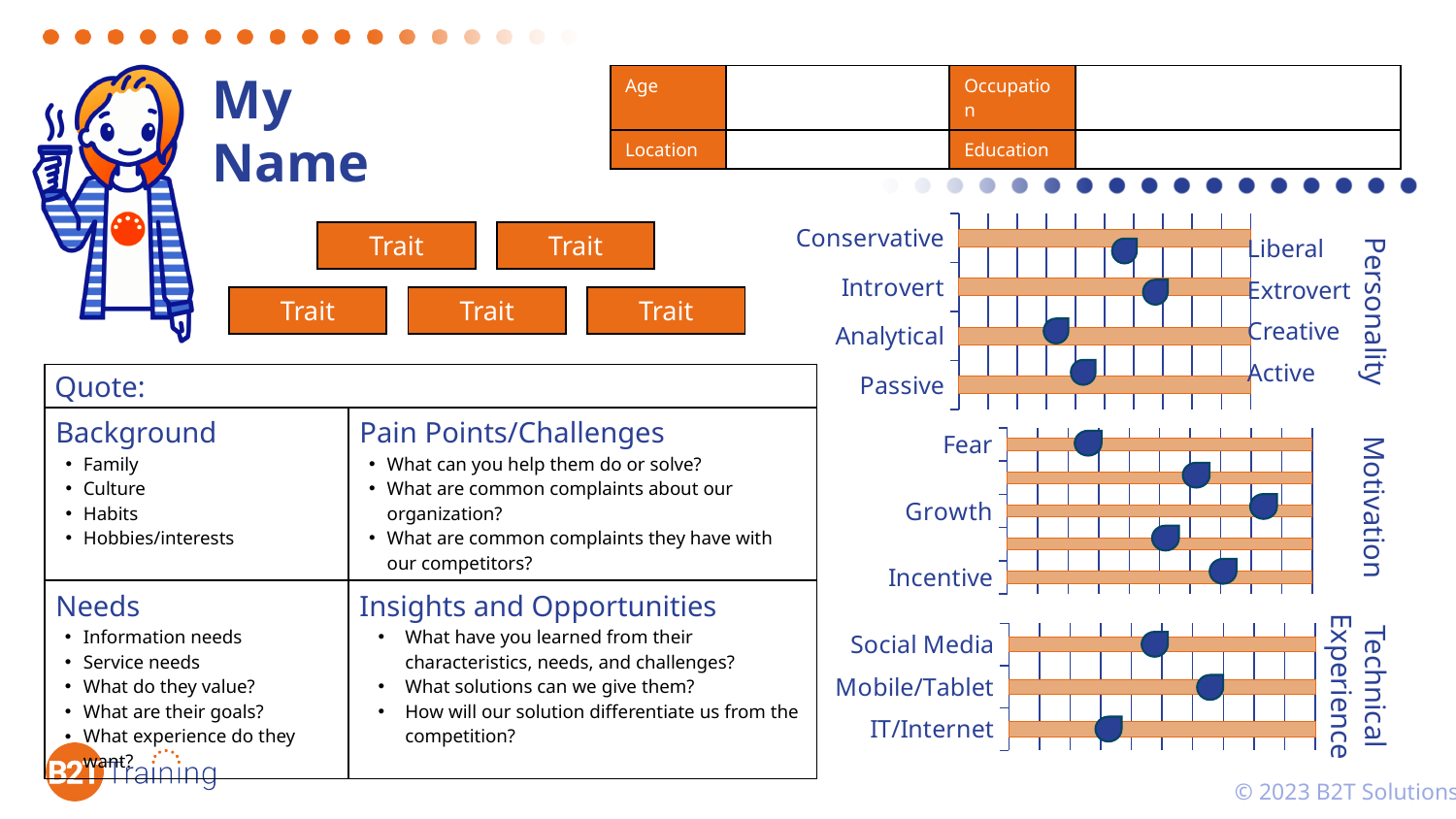
In the Technical Experience chart, which row has its marker positioned furthest to the right? Mobile/Tablet In the Technical Experience chart, which row has its marker positioned furthest to the left? IT/Internet What kind of chart is used for the Personality section on the right of the slide? bar chart In the Motivation chart, which labelled row has its marker positioned furthest to the left? Fear In the Personality chart, is the marker for the Introvert/Extrovert row to the right or to the left of the marker for the Analytical/Creative row? to the right How many rows (bars) does the Motivation chart contain? 5 How many rows (bars) does the Technical Experience chart contain? 3 In the Personality chart, which row has its marker positioned furthest to the left? Analytical/Creative How many rows (bars) does the Personality chart contain? 4 In the Personality chart, which row has its marker positioned furthest to the right? Introvert/Extrovert What are the titles of the three slider charts on the right side of the slide, from top to bottom? Personality, Motivation, Technical Experience What label appears on the right end of the Conservative row in the Personality chart? Liberal